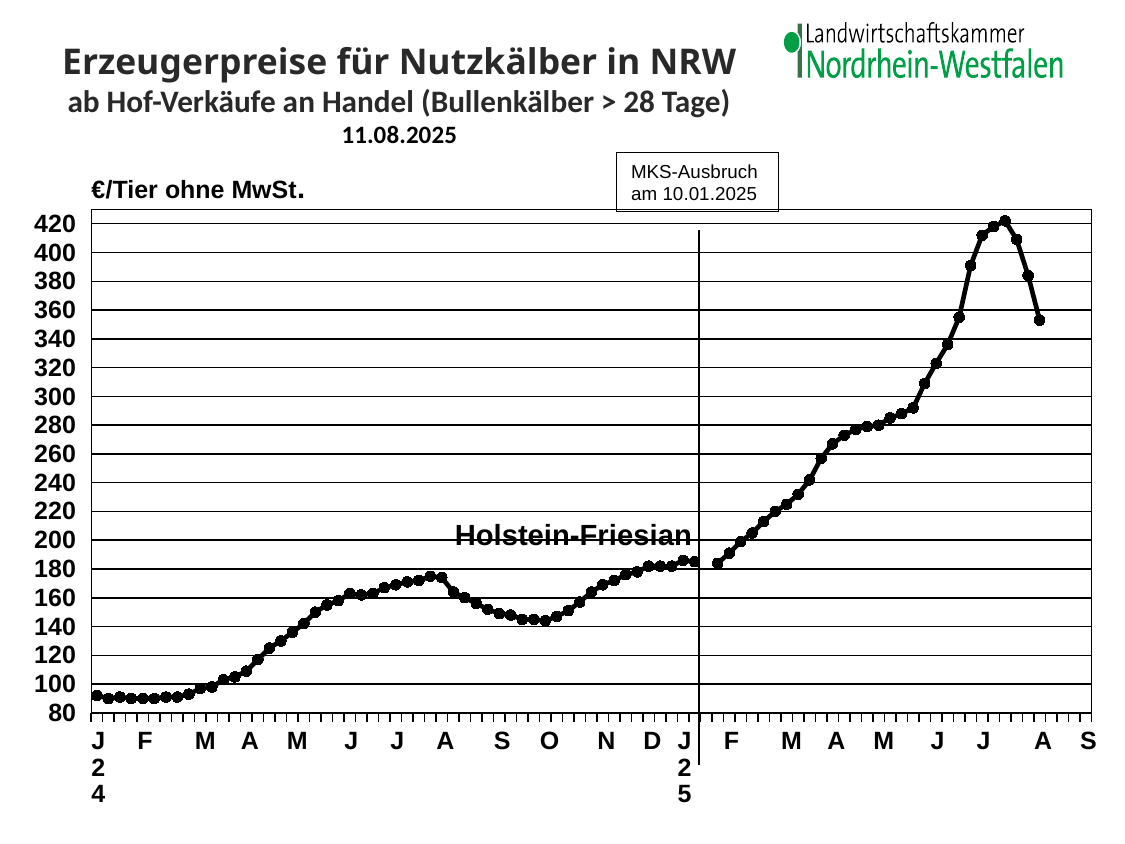
What kind of chart is shown on the slide? line chart Is the highest value in July 2025 greater or less than 400? greater Is the value for January 2024 greater or less than 100? less Is the value for April 2025 greater or less than 240? greater Does the line rise or fall from its peak in July 2025 to August 2025? fall What event does the annotation box above the vertical line in the chart refer to, and on what date? MKS-Ausbruch am 10.01.2025 Does the line rise or fall from January 2025 to July 2025? rise How many data series are plotted in the chart? 1 In which month does the line reach its highest point? July 2025 What is the unit label shown above the y-axis of the chart? €/Tier ohne MwSt.